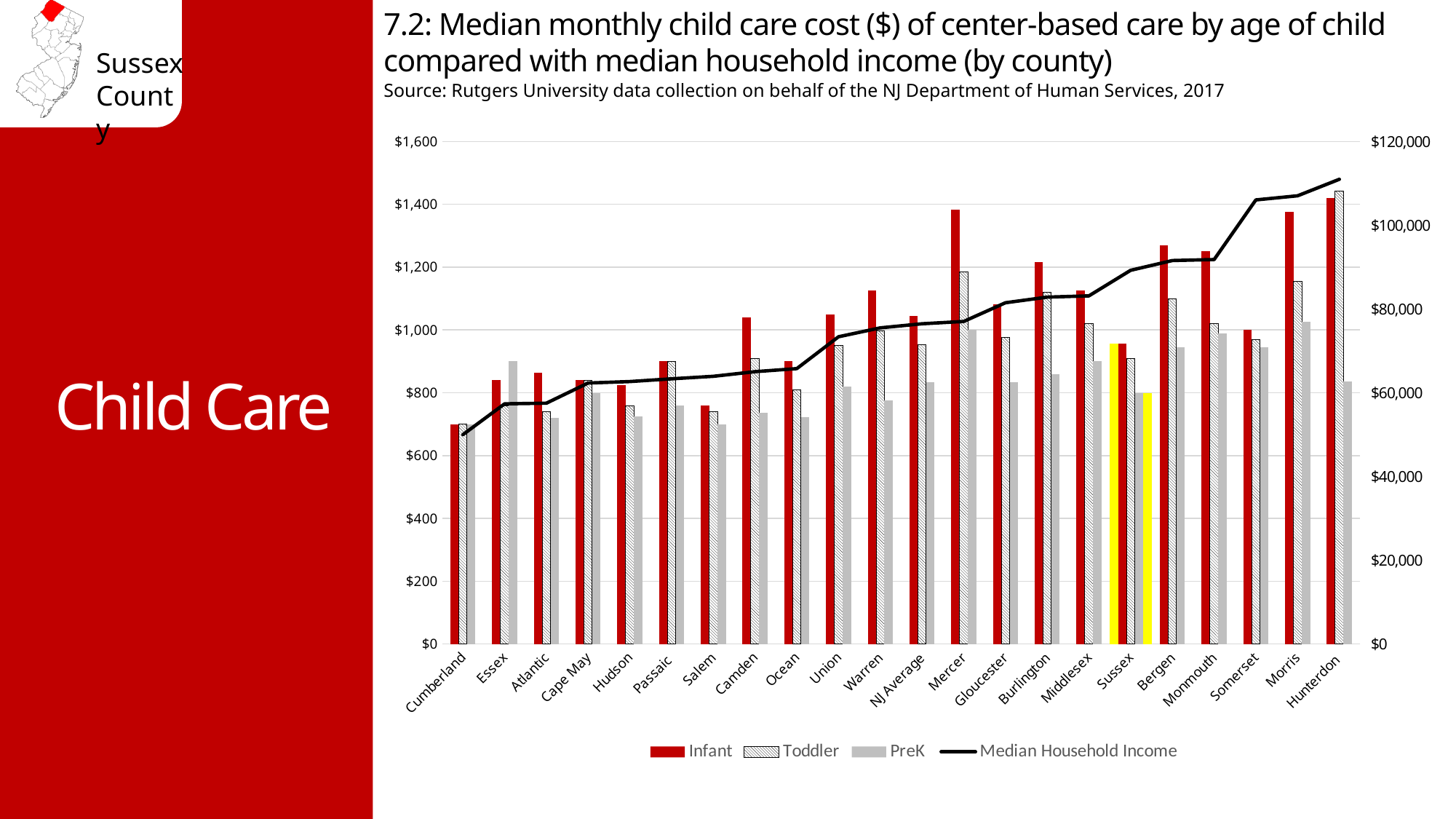
Is the Median Household Income for Hunterdon greater or less than $100,000? greater How many counties/categories are shown on the x axis? 22 Which category has the lowest Infant cost? Cumberland Which category has the highest Median Household Income? Hunterdon How many series does the legend list? 4 What kind of chart is this? A bar chart with a line Does the Median Household Income line generally rise or fall from left to right across the counties? Rise Is the Infant cost for Mercer greater or less than $1,200? greater Is the Infant cost for Sussex greater or less than $1,000? less Which county's bars are highlighted in yellow? Sussex Which category has the highest Toddler cost? Hunterdon Which is larger, the Infant cost for Mercer or the Infant cost for Sussex? Mercer